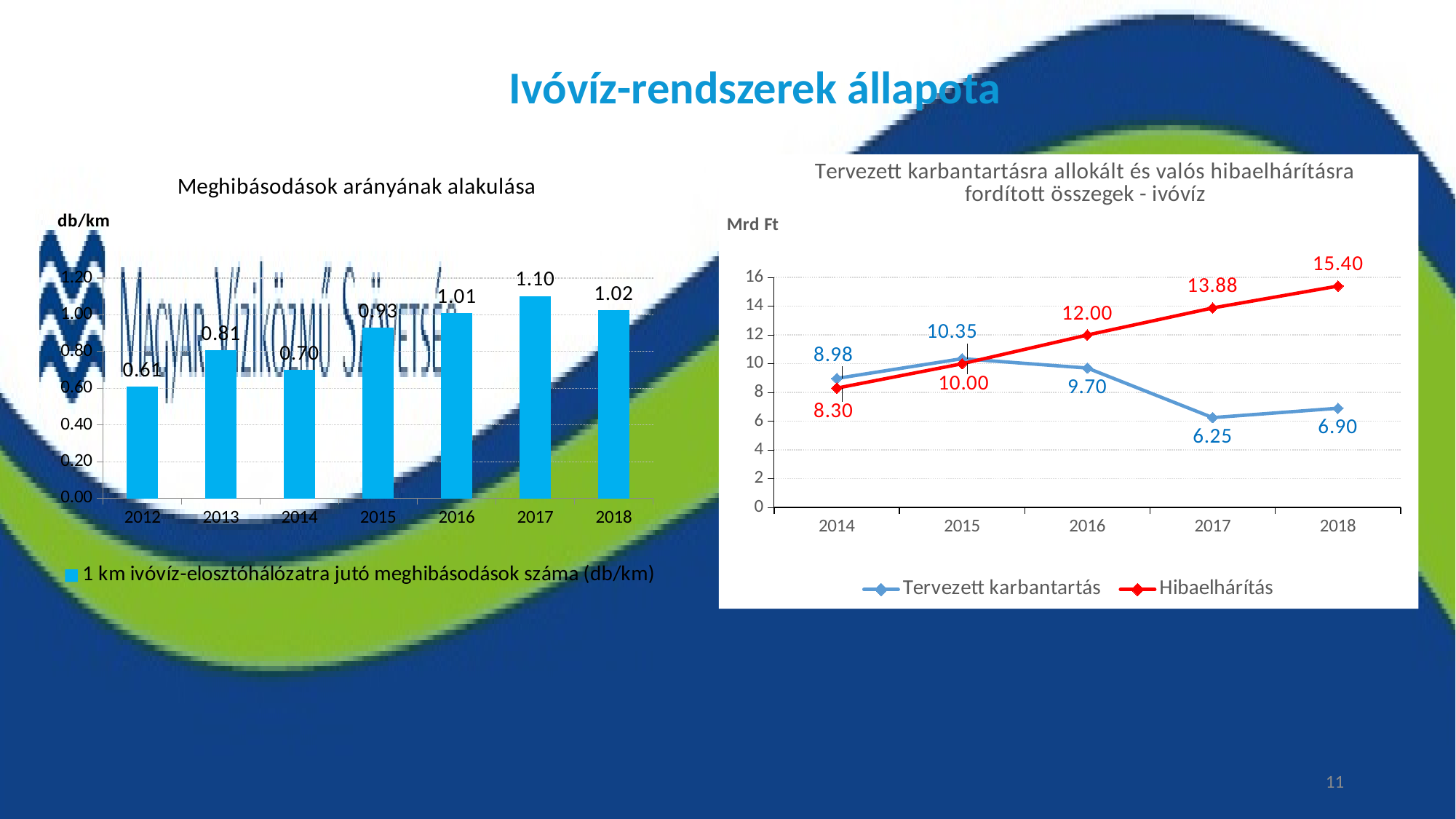
In the right-hand chart, what is the difference between Hibaelhárítás and Tervezett karbantartás in 2016? 2.30 In the chart 'Meghibásodások arányának alakulása', what is the value for 2017? 1.10 In the chart 'Meghibásodások arányának alakulása', how many years are shown on the x axis? 7 In the right-hand chart, does Hibaelhárítás rise or fall from 2014 to 2018? rise What kind of chart is 'Meghibásodások arányának alakulása'? bar chart In the right-hand chart, what is the value of Hibaelhárítás in 2018? 15.40 In the chart 'Meghibásodások arányának alakulása', what is the difference between the values for 2018 and 2012? 0.41 In the right-hand chart, which is larger in 2014: Tervezett karbantartás or Hibaelhárítás? Tervezett karbantartás How many series does the legend of the right-hand chart list? 2 In the chart 'Meghibásodások arányának alakulása', which year has the highest value? 2017 In the chart 'Meghibásodások arányának alakulása', which year has the lowest value? 2012 In the right-hand chart, what is the value of Tervezett karbantartás in 2017? 6.25